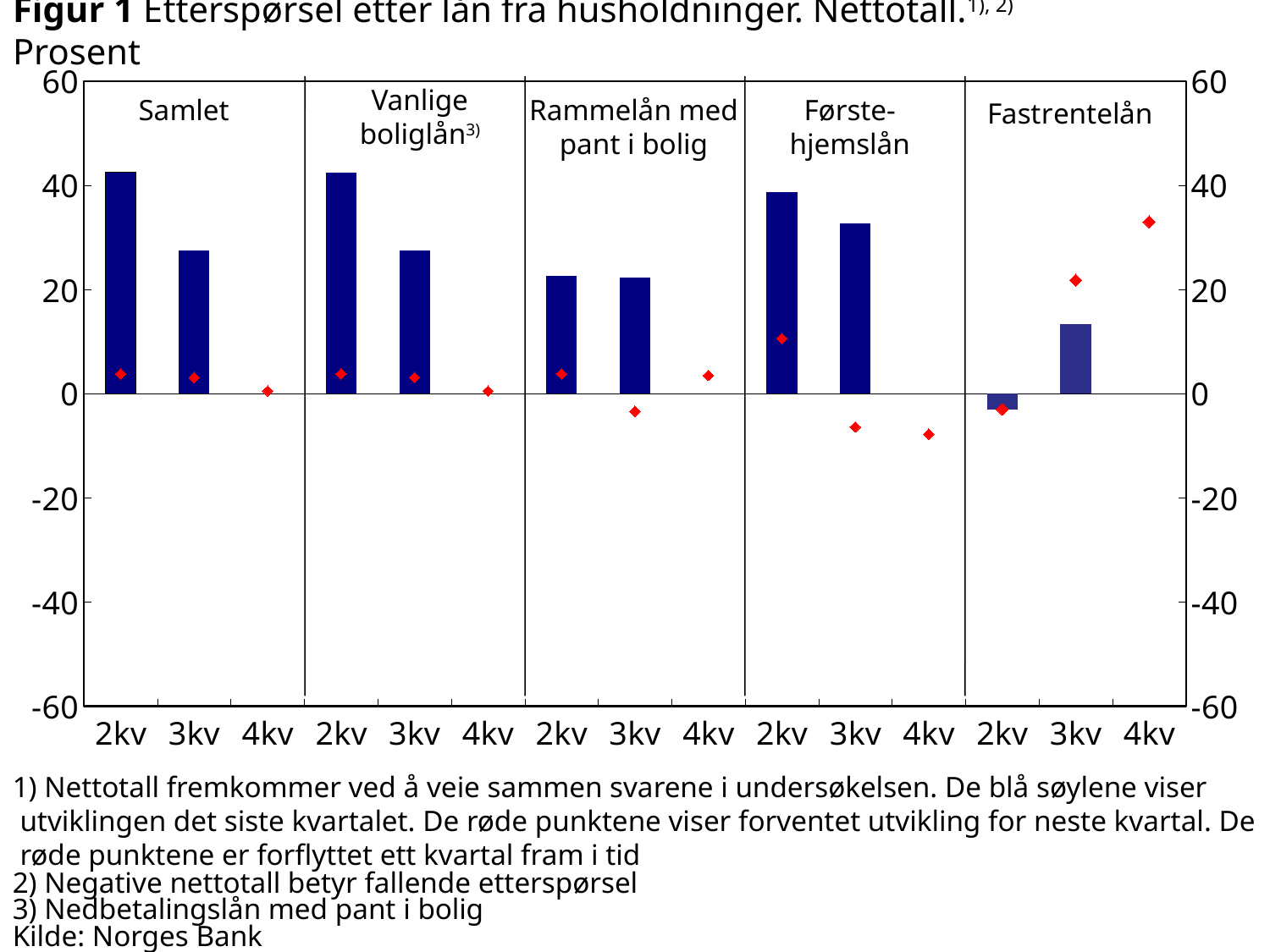
What is the source given for the chart? Norges Bank In the Fastrentelån panel, is the red point for 4kv greater or less than 20? greater What kind of chart is shown in Figur 1? bar chart In the Samlet panel, is the blue bar for 3kv greater or less than 20? greater In the Fastrentelån panel, is the blue bar for 3kv greater or less than 20? less How many loan categories (panels) are shown in the chart? 5 Which panel has the lowest blue bar for 2kv? Fastrentelån In the Samlet panel, which blue bar is larger, 2kv or 3kv? 2kv In the Fastrentelån panel, do the red points rise or fall from 2kv to 4kv? rise